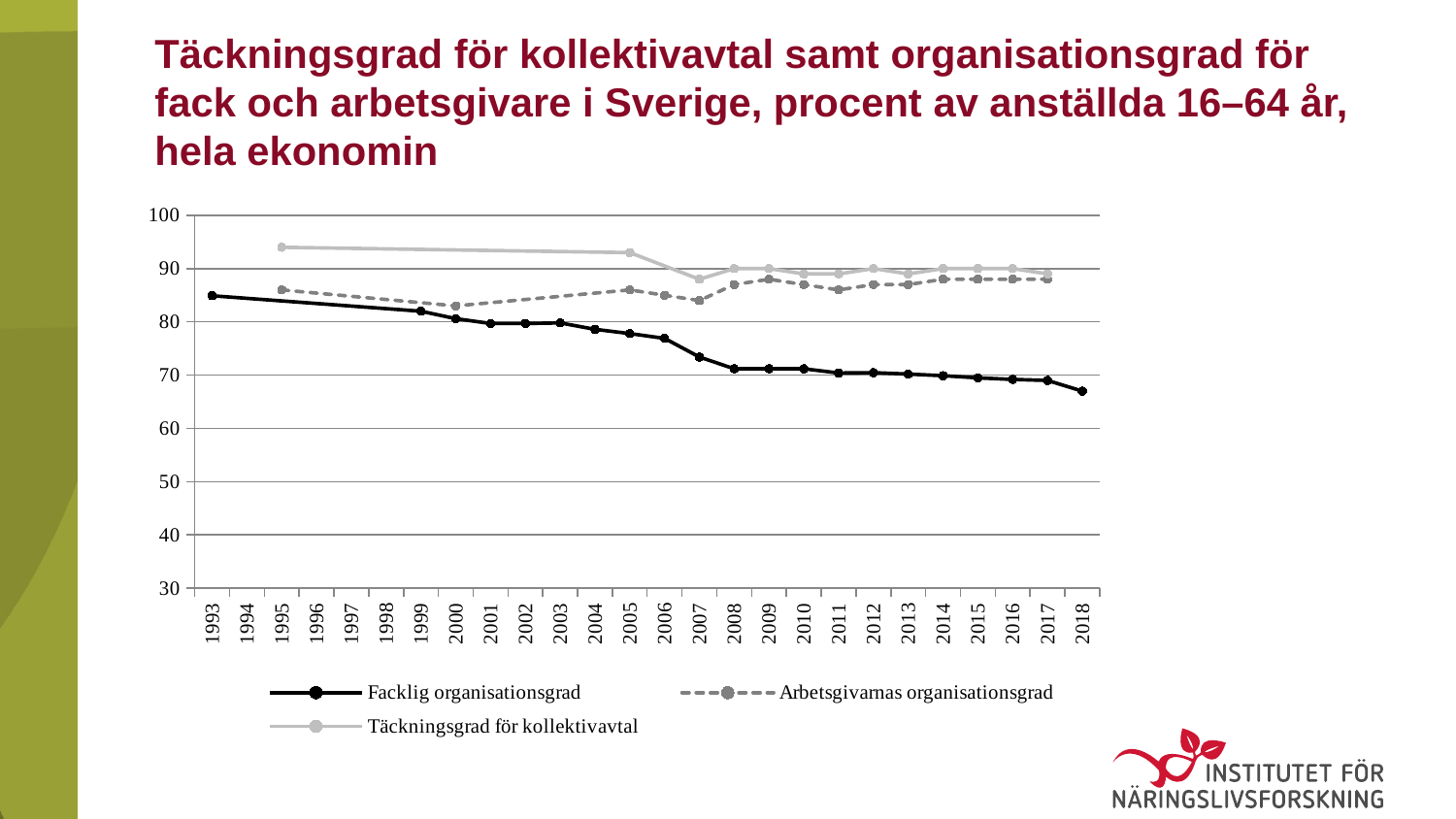
Which series has the highest value in 1995? Täckningsgrad för kollektivavtal Does the Facklig organisationsgrad series rise or fall from 1993 to 2018? fall How many years are shown along the x axis? 26 Which series has the lowest value in 2018? Facklig organisationsgrad Is the value for Facklig organisationsgrad in 2018 greater or less than 70? less Which is larger for Facklig organisationsgrad: the value in 1993 or the value in 2018? 1993 How many series does the legend list? 3 Is the value for Arbetsgivarnas organisationsgrad in 2007 greater or less than 90? less Which series is drawn with a dashed line? Arbetsgivarnas organisationsgrad What kind of chart is shown on the slide? line chart Is the value for Facklig organisationsgrad in 1993 greater or less than 80? greater